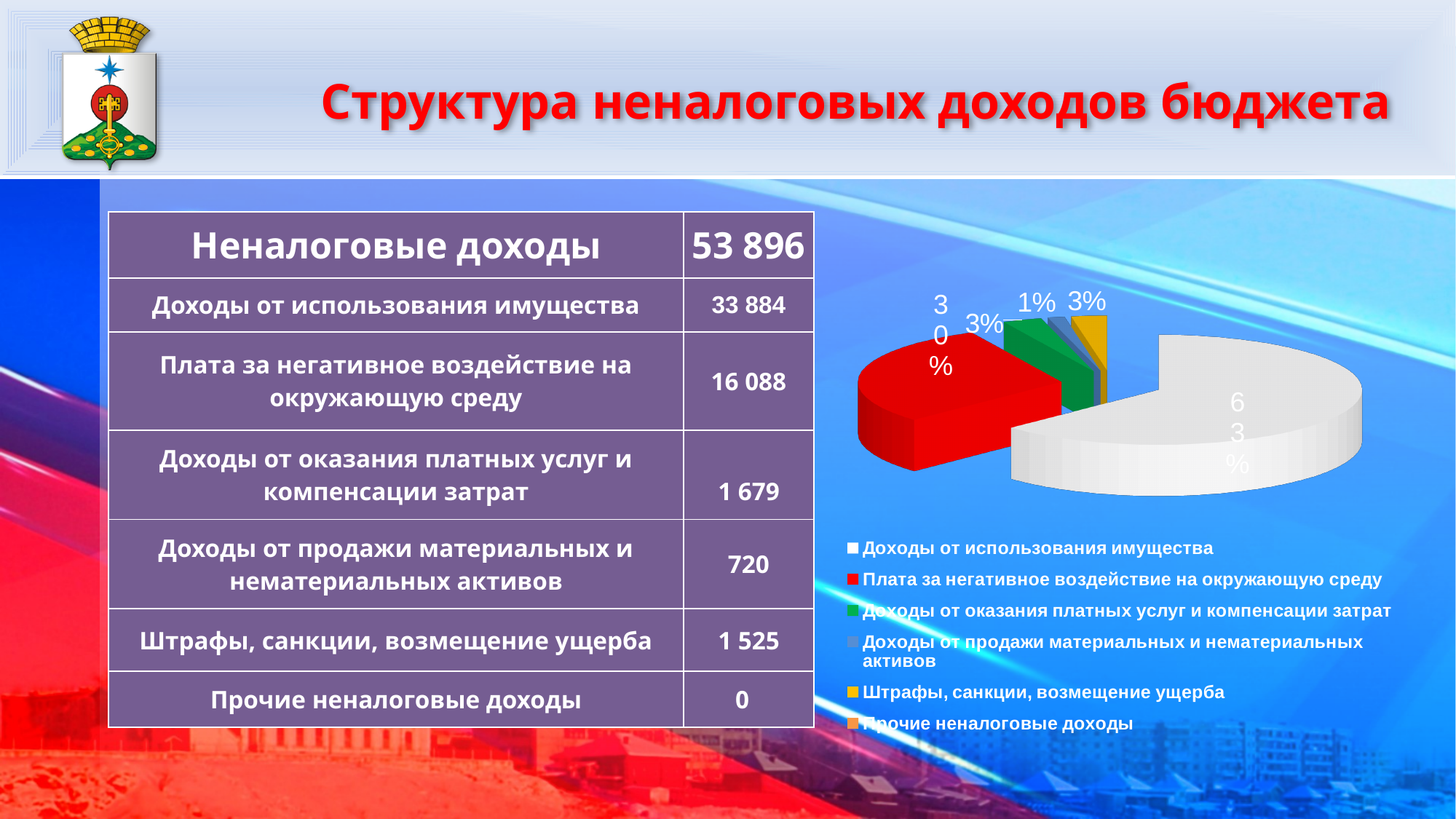
What share of the pie does "Штрафы, санкции, возмещение ущерба" take? 3% What share of the pie does "Доходы от использования имущества" take? 63% What share of the pie does "Плата за негативное воздействие на окружающую среду" take? 30% How many entries does the legend of the pie chart list? 6 What colour represents "Плата за негативное воздействие на окружающую среду" in the pie chart? Red Which category has the largest slice of the pie? Доходы от использования имущества Which labelled slice of the pie has the smallest share? Доходы от продажи материальных и нематериальных активов What kind of chart is shown on the slide? Pie chart Which slice is larger: "Плата за негативное воздействие на окружающую среду" or "Доходы от использования имущества"? Доходы от использования имущества By how many percentage points does the share of "Доходы от использования имущества" exceed the share of "Плата за негативное воздействие на окружающую среду"? 33 percentage points